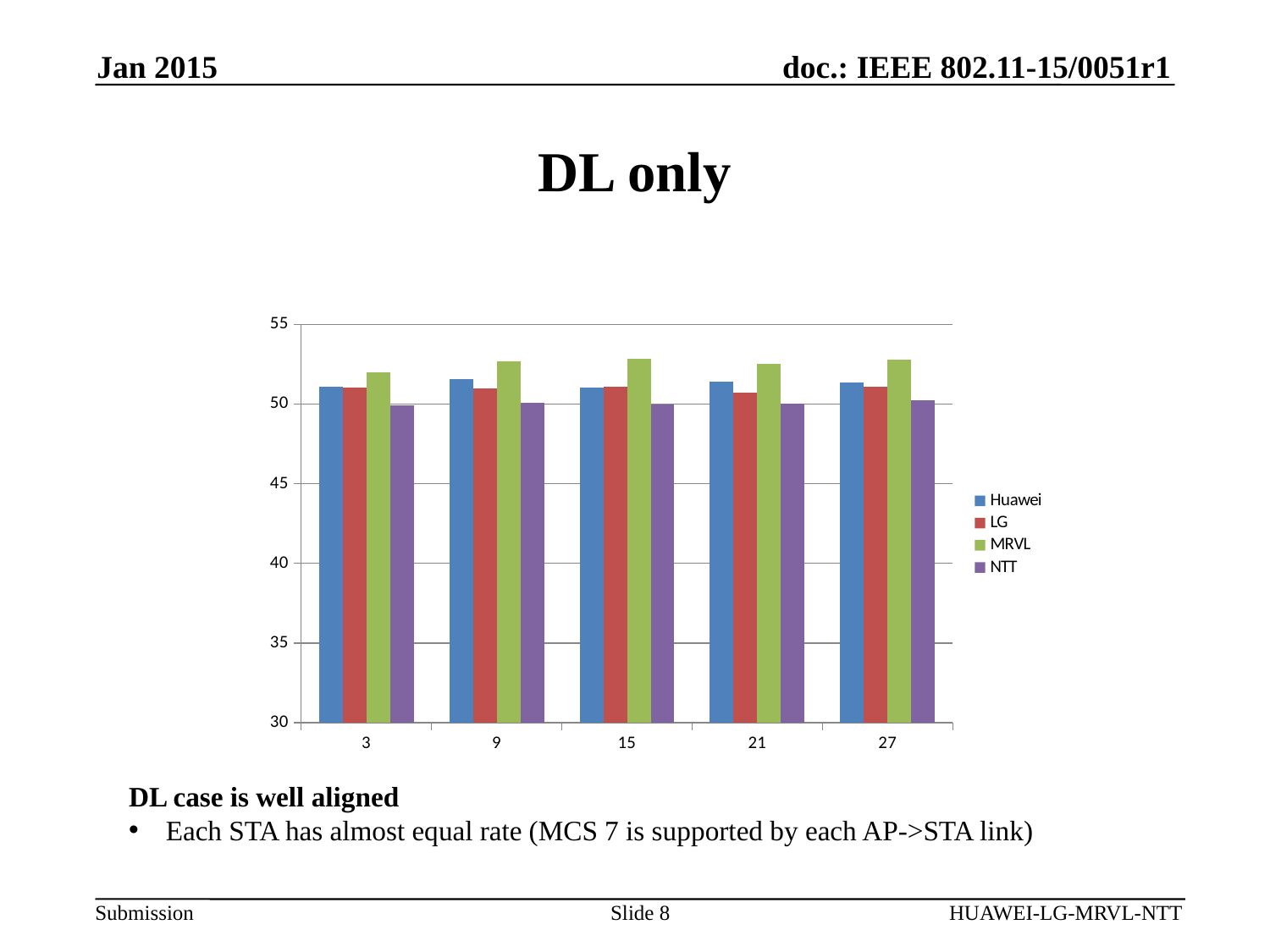
Which is larger at category 9, the Huawei value or the NTT value? Huawei Which series has the highest value at category 27? MRVL Which is larger at category 21, the MRVL value or the NTT value? MRVL What kind of chart is shown on the slide? bar chart How many categories are shown along the x axis? 5 Is the MRVL value at category 21 greater or less than 55? less Is the Huawei value at category 27 greater or less than 45? greater Is the MRVL value at category 9 greater or less than 50? greater What is the title of the chart on the slide? DL only Which series has the lowest value at category 3? NTT How many series does the legend list? 4 Which series has the highest value at category 15? MRVL